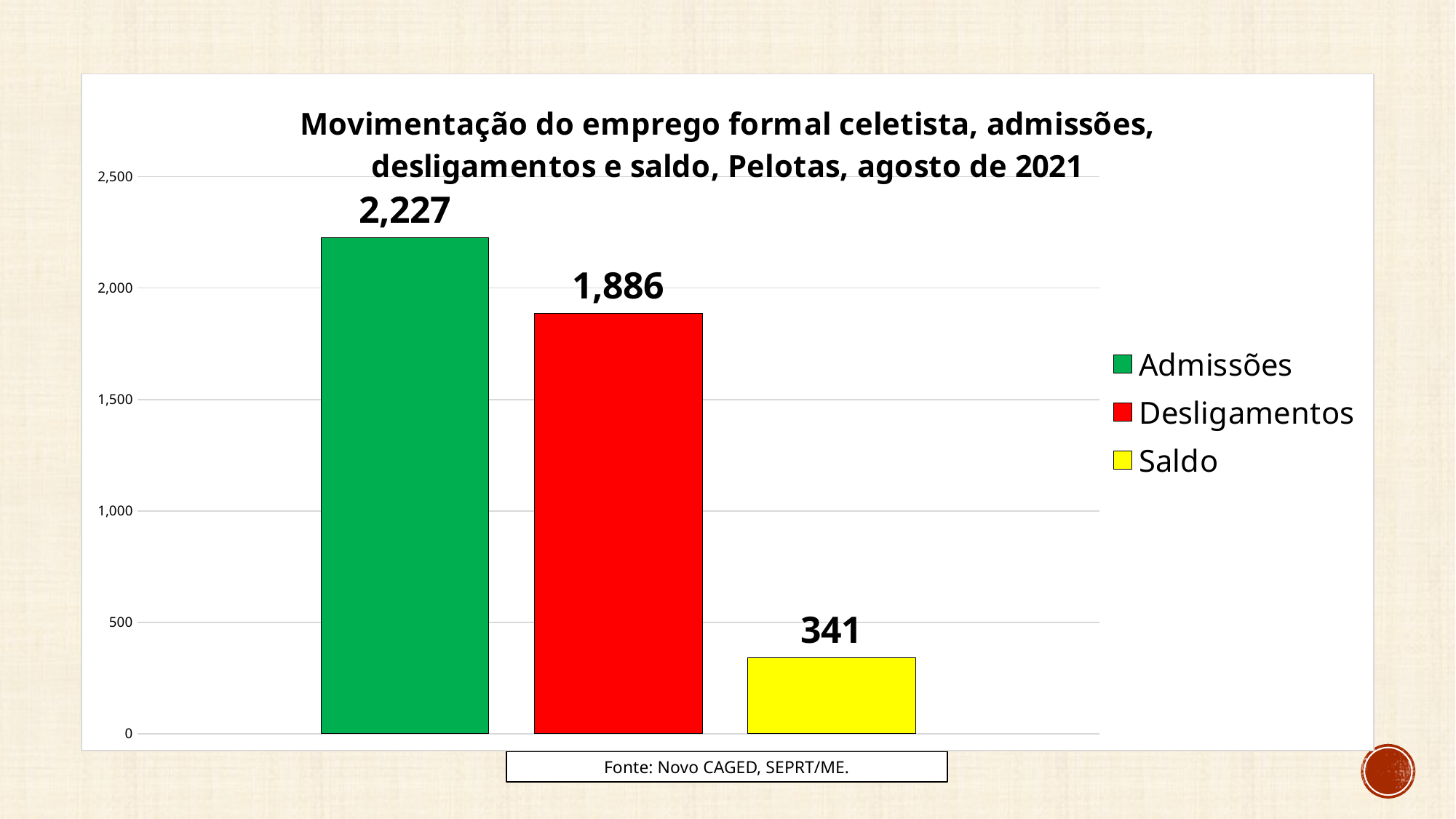
Is the value for Desligamentos greater or less than 2,000? less What is the difference between Admissões and Desligamentos? 341 Which series has the lowest value? Saldo What kind of chart is shown on the slide? bar chart How many bars are plotted in the chart? 3 Which is larger, Desligamentos or Saldo? Desligamentos What is the value for Admissões? 2,227 How many series does the legend list? 3 Which series has the highest value? Admissões What colour is the bar for Saldo? yellow What is the value for Desligamentos? 1,886 What is the value for Saldo? 341